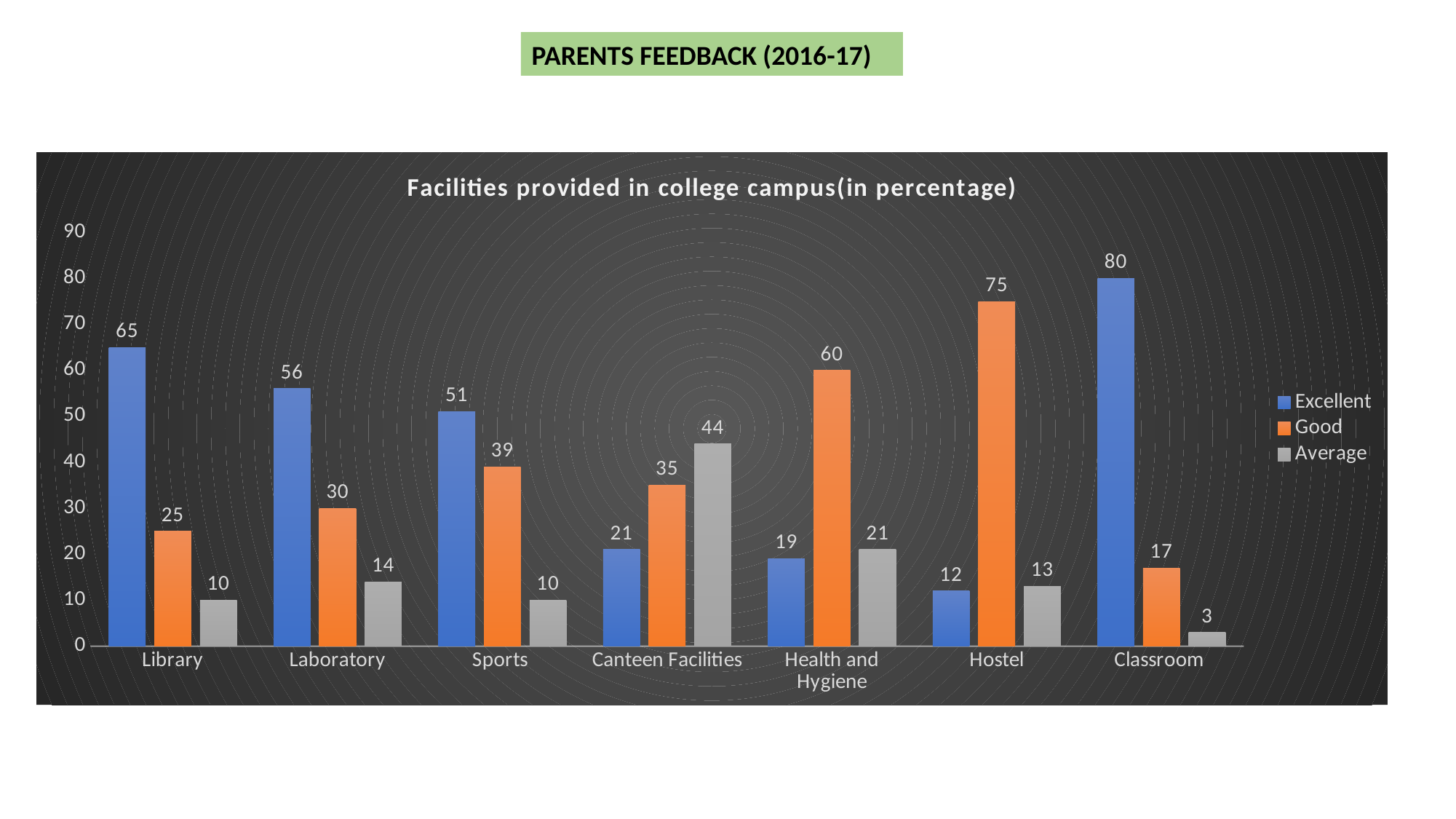
Which category has the lowest Average value? Classroom What is the title of the chart? Facilities provided in college campus(in percentage) Which is larger, the Excellent value for Laboratory or the Excellent value for Sports? Laboratory How many categories are shown on the x axis? 7 How many series does the legend list? 3 What is the Average value for Canteen Facilities? 44 What is the Good value for Hostel? 75 Is the Good value for Canteen Facilities greater or less than 30? greater Which category has the highest Excellent value? Classroom What kind of chart is shown? bar chart What is the difference between the Good value for Health and Hygiene and the Good value for Sports? 21 What is the Excellent value for Library? 65